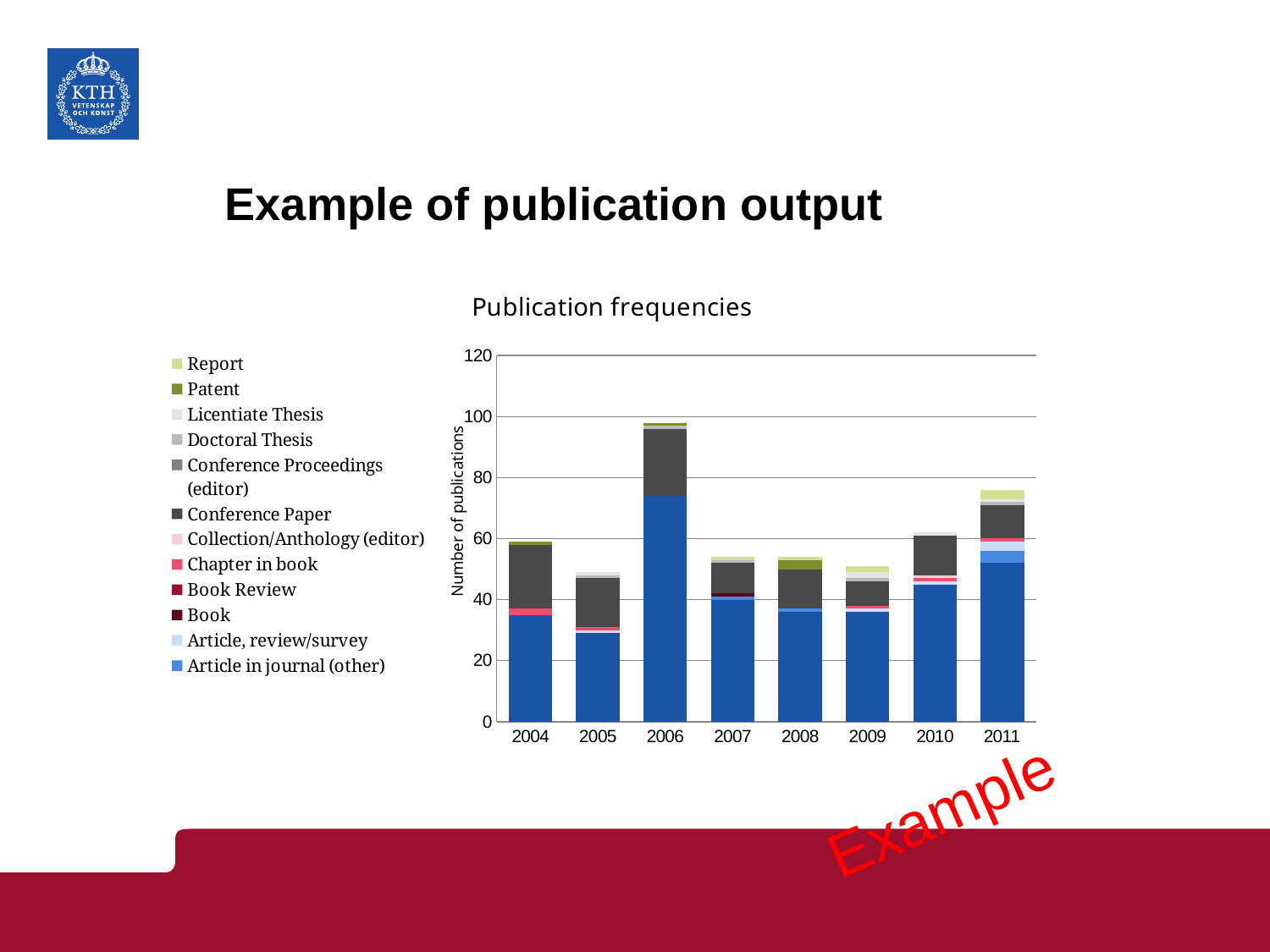
Which year has the larger total number of publications, 2007 or 2011? 2011 Is the total number of publications in 2006 greater or less than 80? greater What is the title of the chart? Publication frequencies Which year has the larger total number of publications, 2004 or 2006? 2006 Is the total number of publications in 2005 greater or less than 60? less How many series does the legend list? 12 What kind of chart is shown on the slide? Stacked bar chart How many years are shown along the x axis of the chart? 8 Is the total number of publications in 2011 greater or less than 60? greater Which year has the highest total number of publications? 2006 What is the label of the vertical axis? Number of publications